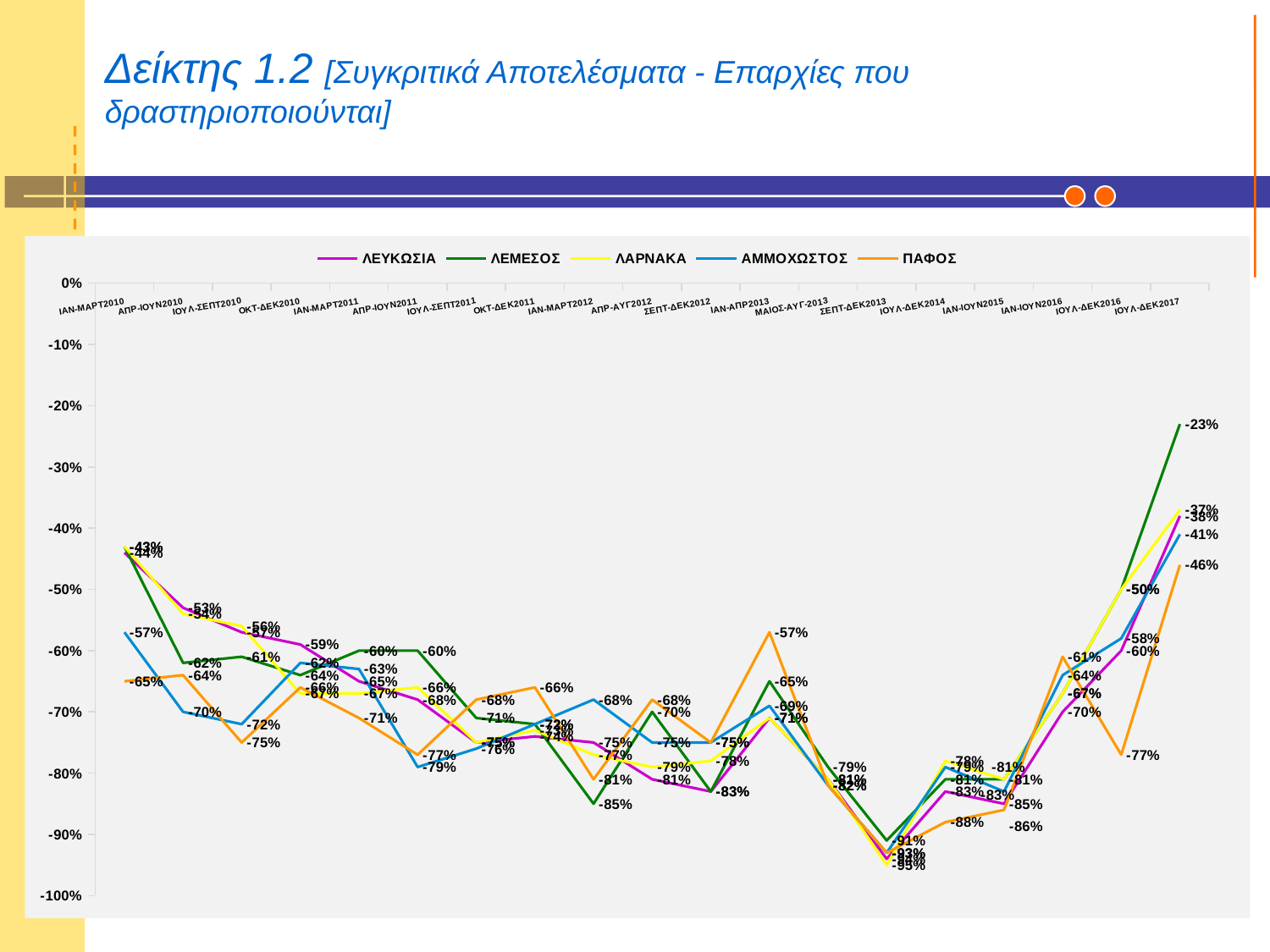
What kind of chart is shown on the slide? Line chart Which series has the lowest value at ΙΟΥΛ-ΔΕΚ2017? ΠΑΦΟΣ What is the value for ΠΑΦΟΣ at ΙΟΥΛ-ΔΕΚ2017? -46% At ΜΑΙΟΣ-ΑΥΓ-2013, which is higher: ΠΑΦΟΣ or ΛΕΜΕΣΟΣ? ΛΕΜΕΣΟΣ What is the value for ΠΑΦΟΣ at ΜΑΙΟΣ-ΑΥΓ-2013? -82% How many time periods are shown along the x axis? 19 What is the difference between the ΛΕΜΕΣΟΣ and ΠΑΦΟΣ values at ΙΟΥΛ-ΔΕΚ2017? 23 percentage points What is the value for ΛΕΜΕΣΟΣ at ΙΟΥΛ-ΔΕΚ2017? -23% Does the ΛΕΜΕΣΟΣ line rise or fall from ΙΑΝ-ΙΟΥΝ2015 to ΙΟΥΛ-ΔΕΚ2017? Rise What colour is the ΠΑΦΟΣ line? Orange Which series has the highest value at ΙΟΥΛ-ΔΕΚ2017? ΛΕΜΕΣΟΣ How many series does the legend list? 5